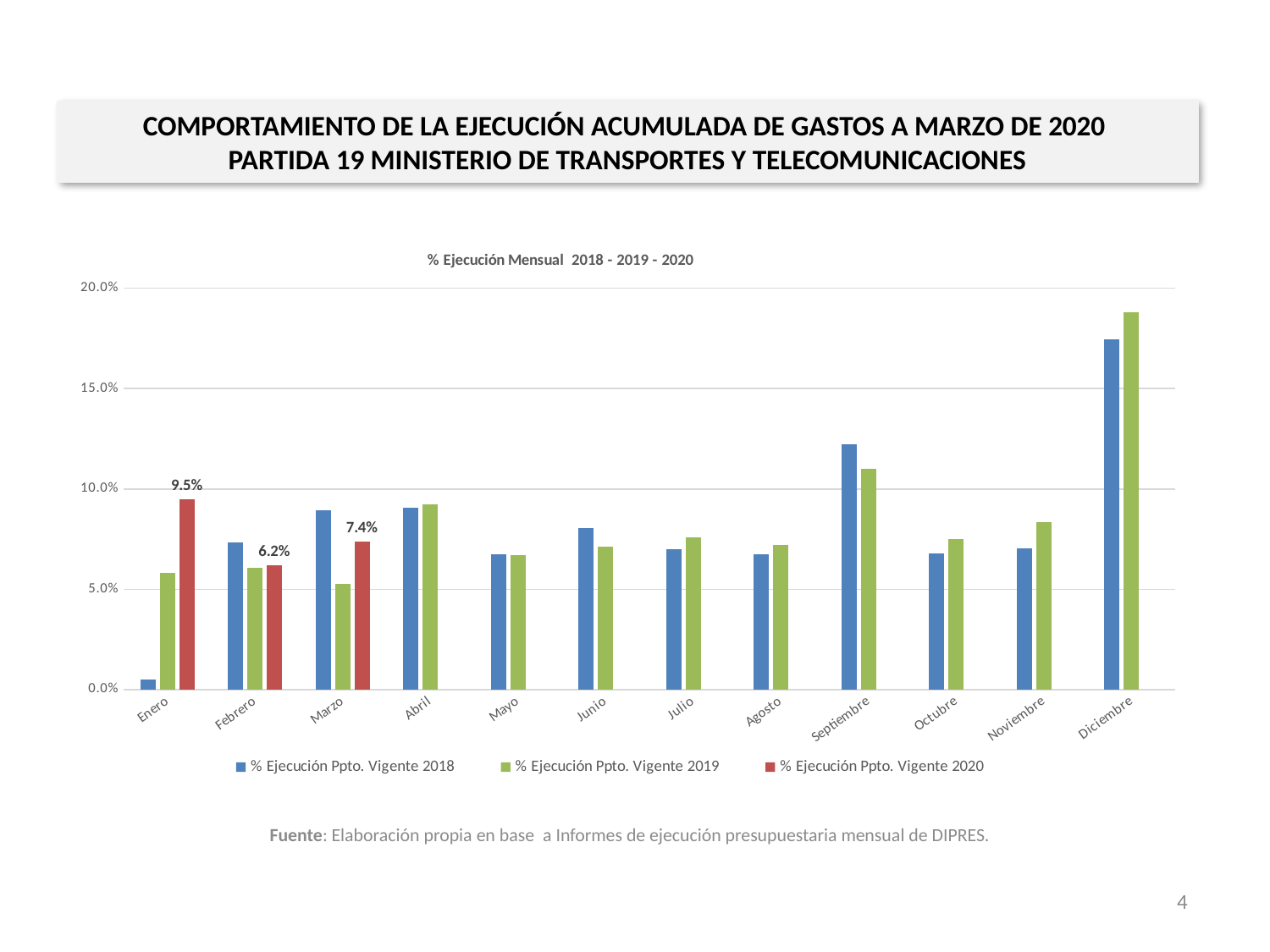
What is the value for Marzo in the % Ejecución Ppto. Vigente 2020 series? 7.4% How many series does the legend list? 3 Which month has the lowest value in the % Ejecución Ppto. Vigente 2020 series? Febrero What is the title of the chart? % Ejecución Mensual 2018 - 2019 - 2020 Which month has the highest value in the % Ejecución Ppto. Vigente 2020 series? Enero Is the value for Diciembre in the % Ejecución Ppto. Vigente 2019 series greater or less than 15.0%? greater What is the value for Febrero in the % Ejecución Ppto. Vigente 2020 series? 6.2% In Septiembre, which series has the larger value: % Ejecución Ppto. Vigente 2018 or % Ejecución Ppto. Vigente 2019? % Ejecución Ppto. Vigente 2018 What is the value for Enero in the % Ejecución Ppto. Vigente 2020 series? 9.5% How many months are shown on the x axis? 12 What is the difference between the Enero and Febrero values in the % Ejecución Ppto. Vigente 2020 series? 3.3% What kind of chart is shown on the slide? bar chart